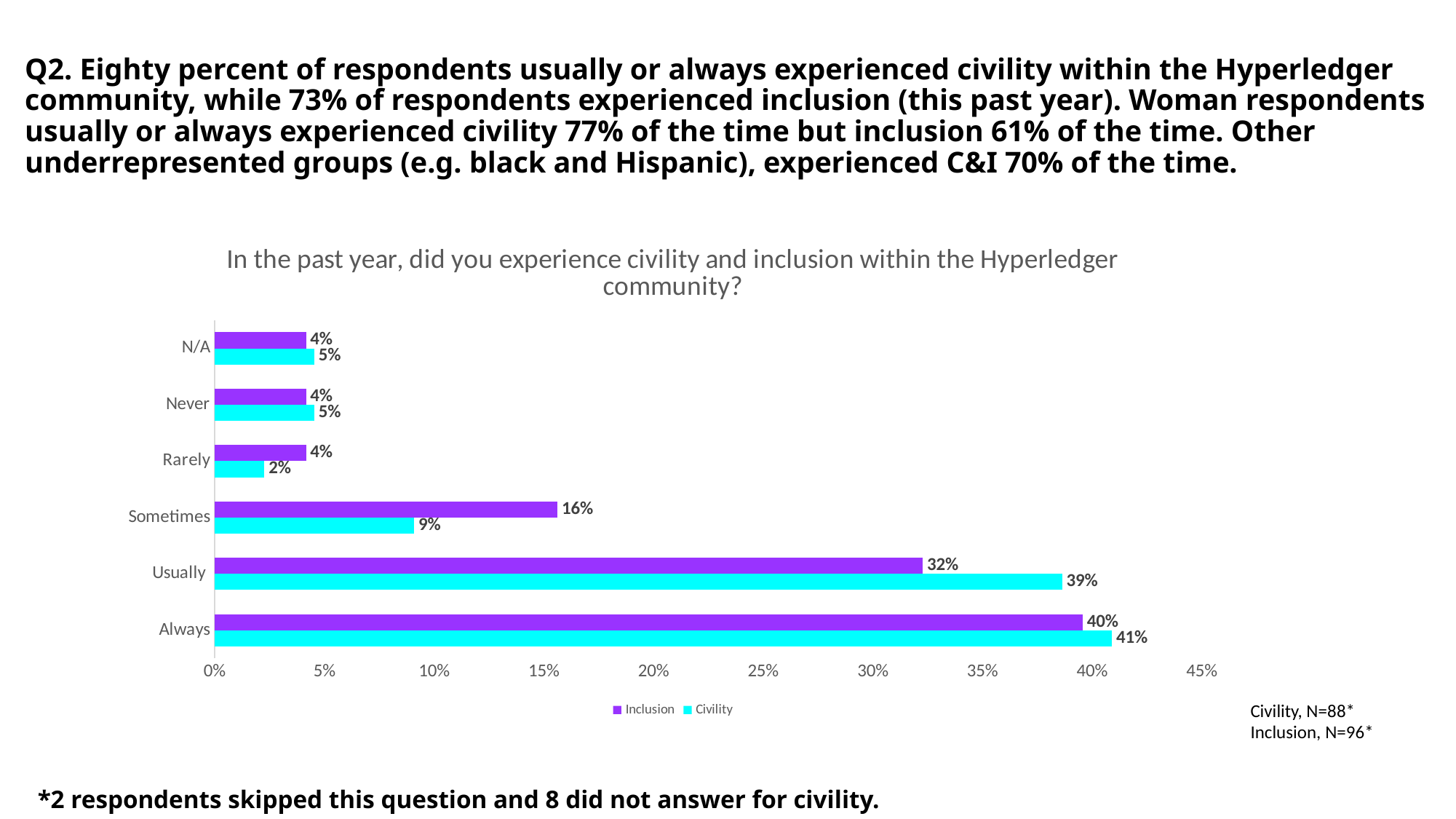
What is the Inclusion value for Rarely? 4% Which category has the highest Civility value? Always What is the difference between the Civility and Inclusion values for Usually? 7% What kind of chart is shown on the slide? Bar chart Which category has the lowest Civility value? Rarely How many categories are shown on the chart? 6 What is the Civility value for Usually? 39% Which colour represents the Civility series? Cyan For Sometimes, which series has the larger value, Inclusion or Civility? Inclusion How many series does the legend list? 2 What is the Inclusion value for Sometimes? 16% What is the Civility value for Always? 41%